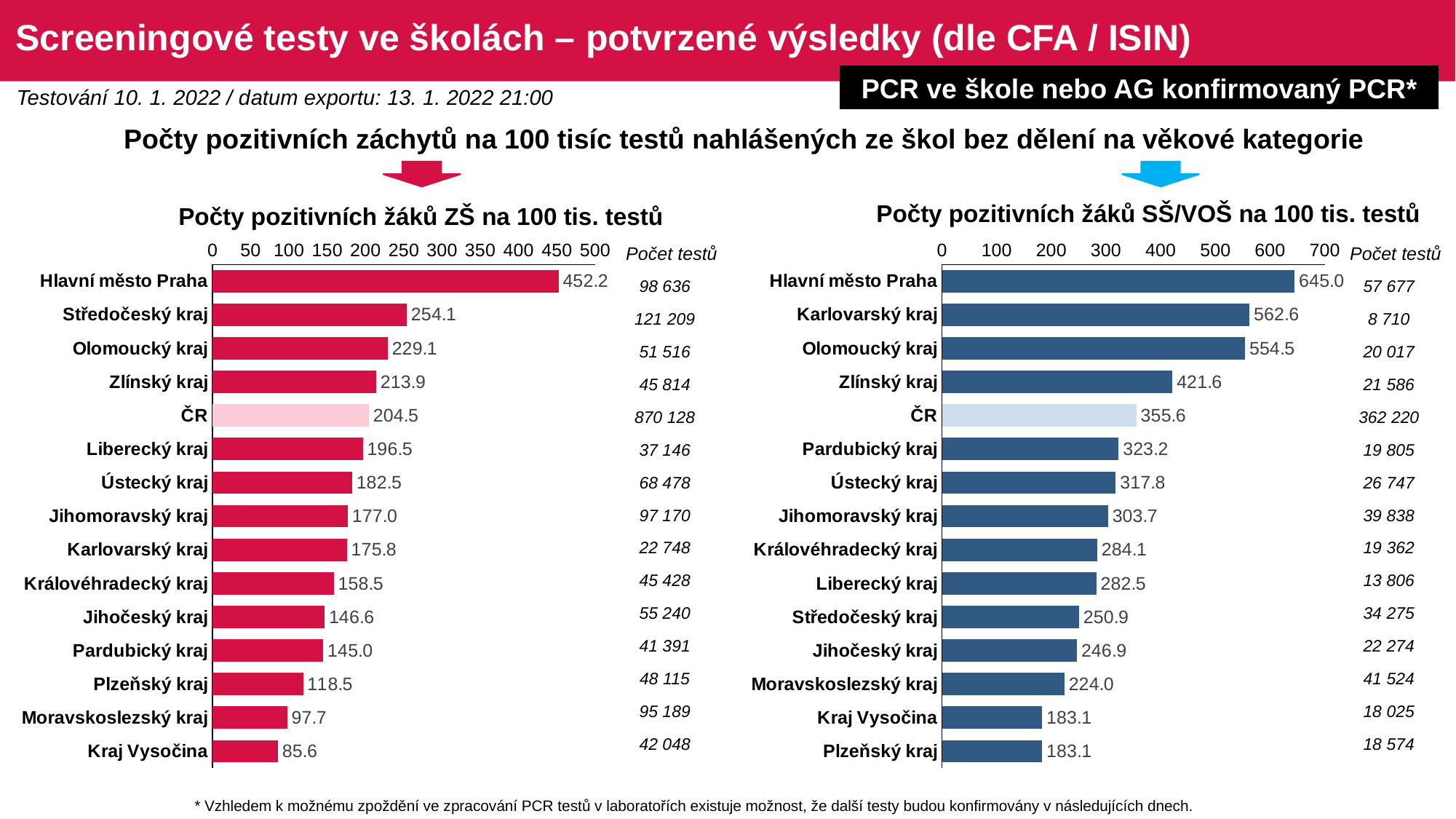
How many categories are shown in the chart 'Počty pozitivních žáků ZŠ na 100 tis. testů'? 15 In the chart 'Počty pozitivních žáků SŠ/VOŠ na 100 tis. testů', what is the value for Karlovarský kraj? 562.6 In the chart 'Počty pozitivních žáků ZŠ na 100 tis. testů', what is the value for ČR? 204.5 In the chart 'Počty pozitivních žáků ZŠ na 100 tis. testů', which category has the lowest value? Kraj Vysočina In the chart 'Počty pozitivních žáků ZŠ na 100 tis. testů', what is the value for Hlavní město Praha? 452.2 In the chart 'Počty pozitivních žáků SŠ/VOŠ na 100 tis. testů', which category has the highest value? Hlavní město Praha In the chart 'Počty pozitivních žáků SŠ/VOŠ na 100 tis. testů', is the value for Zlínský kraj greater or less than 400? greater In the chart 'Počty pozitivních žáků ZŠ na 100 tis. testů', which is larger: the value for Zlínský kraj or the value for Liberecký kraj? Zlínský kraj What kind of chart is 'Počty pozitivních žáků SŠ/VOŠ na 100 tis. testů'? Bar chart In the chart 'Počty pozitivních žáků SŠ/VOŠ na 100 tis. testů', what is the 'Počet testů' value listed for ČR? 362 220 In the chart 'Počty pozitivních žáků ZŠ na 100 tis. testů', what is the difference between the values for Středočeský kraj and Olomoucký kraj? 25.0 In the chart 'Počty pozitivních žáků SŠ/VOŠ na 100 tis. testů', what is the difference between the values for Hlavní město Praha and ČR? 289.4